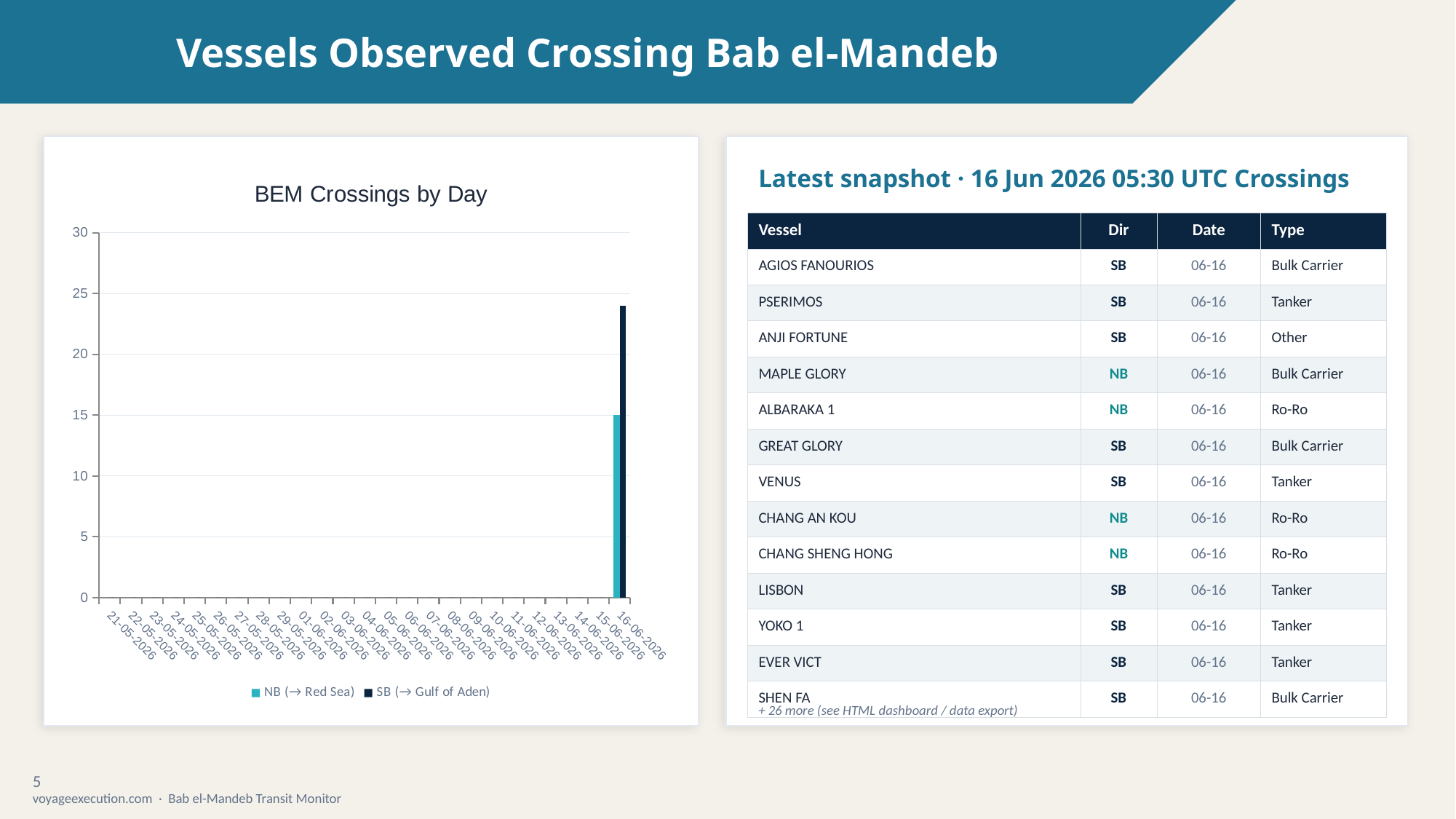
What is the title of the chart on the left of the slide? BEM Crossings by Day How many dates are shown on the x axis of "BEM Crossings by Day"? 25 In "BEM Crossings by Day", is the SB (→ Gulf of Aden) value for 16-06-2026 greater or less than 20? greater In "BEM Crossings by Day", which date has the highest NB (→ Red Sea) value? 16-06-2026 In "BEM Crossings by Day", is the SB (→ Gulf of Aden) value for 16-06-2026 greater or less than 25? less How many series does the legend of "BEM Crossings by Day" list? 2 In "BEM Crossings by Day", is the NB (→ Red Sea) value for 16-06-2026 greater or less than 10? greater What are the two legend entries in "BEM Crossings by Day"? NB (→ Red Sea) and SB (→ Gulf of Aden) In "BEM Crossings by Day", which series has the larger value on 16-06-2026, NB (→ Red Sea) or SB (→ Gulf of Aden)? SB (→ Gulf of Aden) In "BEM Crossings by Day", what is the NB (→ Red Sea) value for 16-06-2026? 15 In "BEM Crossings by Day", which date has the highest SB (→ Gulf of Aden) value? 16-06-2026 What kind of chart is "BEM Crossings by Day"? bar chart